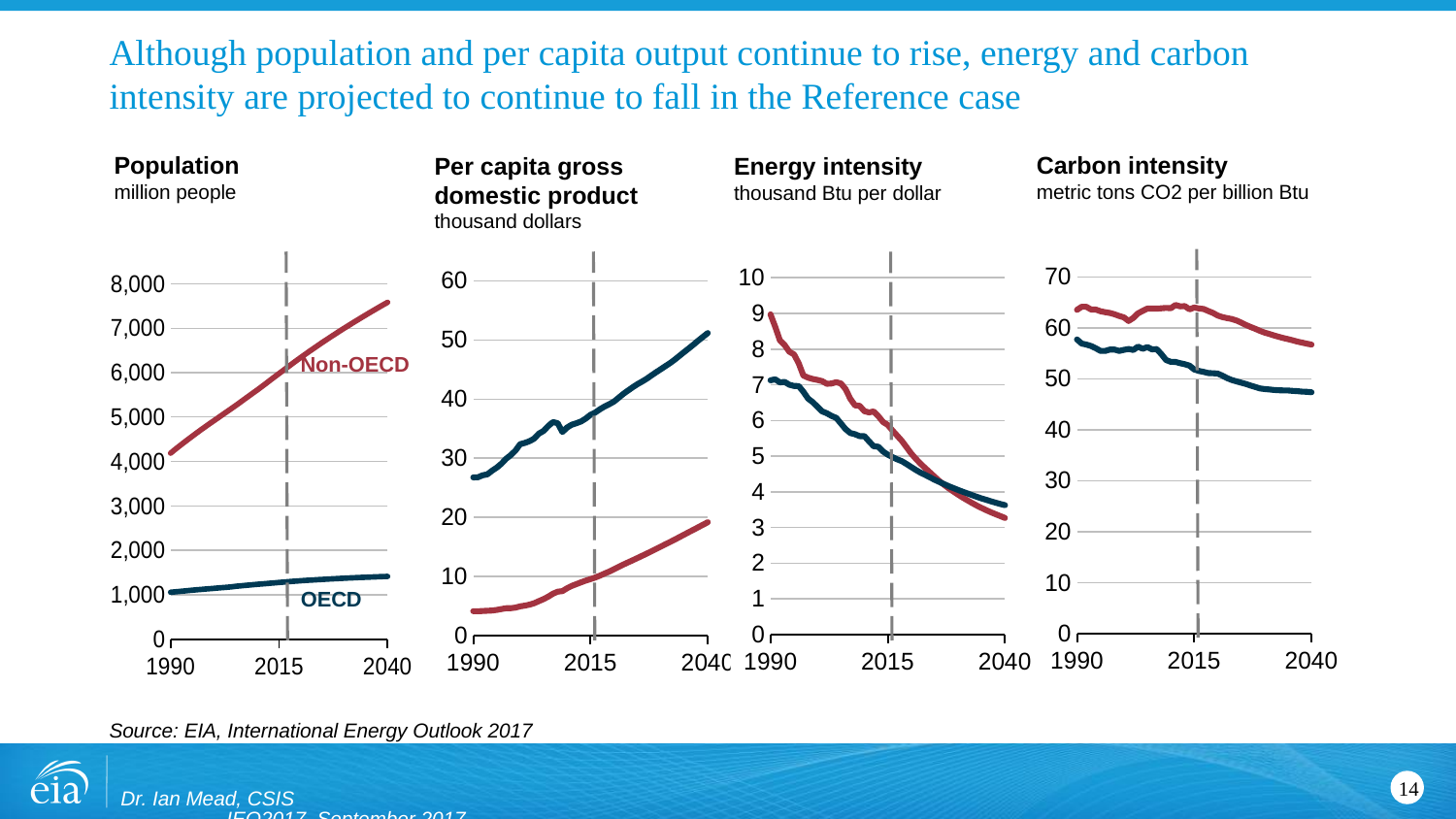
What kind of chart is the Population chart? line chart In the Population chart, which series is higher in 2040, Non-OECD or OECD? Non-OECD In the Population chart, is the OECD value in 2040 greater or less than 2,000? less In the Carbon intensity chart, is the blue line's value in 2040 greater or less than 50? less In the Per capita gross domestic product chart, is the red line's value in 2040 greater or less than 30? less What unit is shown under the Carbon intensity chart title? metric tons CO2 per billion Btu In the Energy intensity chart, do the values rise or fall from 1990 to 2040? fall How many charts are shown on the slide? 4